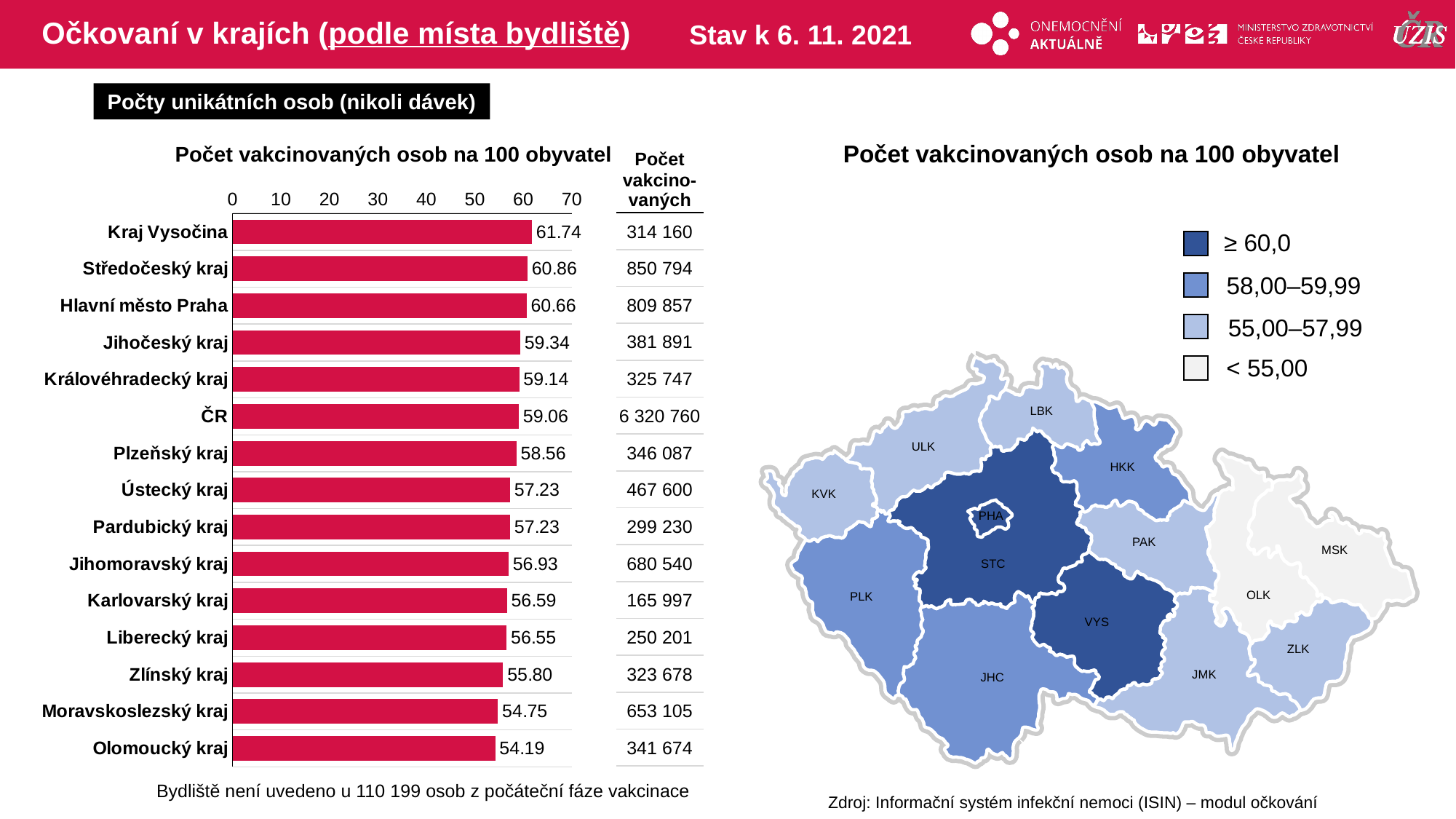
In the bar chart, what is the value for ČR? 59.06 Which category has the lowest value in the bar chart? Olomoucký kraj Is the value for Moravskoslezský kraj in the bar chart greater or less than 60? less In the bar chart, what is the value for Olomoucký kraj? 54.19 In the bar chart, what is the value for Kraj Vysočina? 61.74 What type of chart is shown on the left of the slide under the title 'Počet vakcinovaných osob na 100 obyvatel'? bar chart What is the highest tick value shown on the horizontal axis of the bar chart? 70 What is the difference between the values for Plzeňský kraj and Ústecký kraj in the bar chart? 1.33 In the bar chart, which has a larger value: Středočeský kraj or Hlavní město Praha? Středočeský kraj How many categories (bars) are shown in the bar chart? 15 What is the difference between the values for Kraj Vysočina and Olomoucký kraj in the bar chart? 7.55 Which category has the highest value in the bar chart? Kraj Vysočina